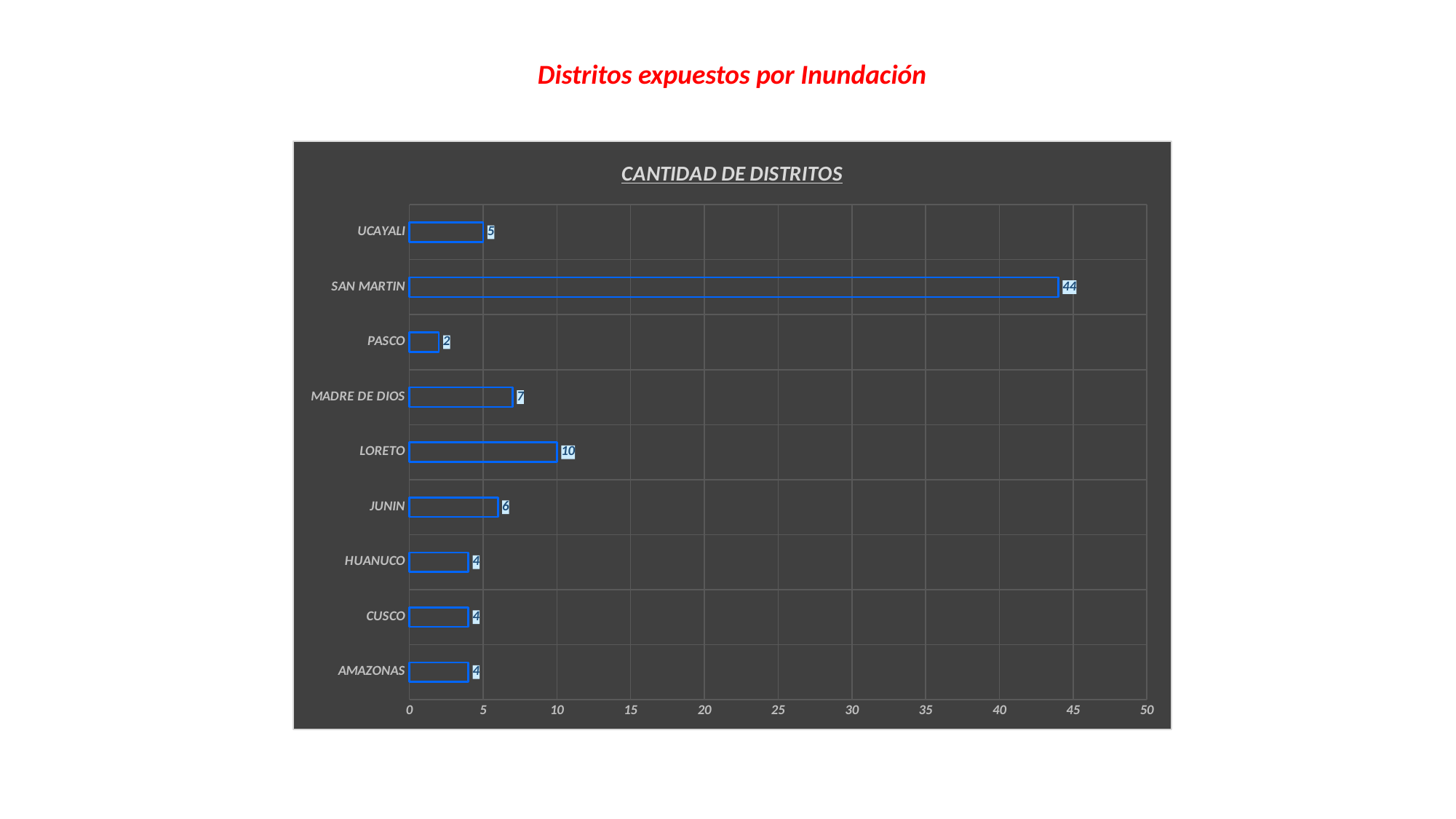
Which category has the lowest value? PASCO What is the difference between the values for SAN MARTIN and LORETO? 34 What is the value for MADRE DE DIOS? 7 What is the title of the chart? CANTIDAD DE DISTRITOS What is the value for LORETO? 10 What is the value for PASCO? 2 Which is larger, the value for JUNIN or the value for UCAYALI? JUNIN How many categories are shown in the chart? 9 What is the value for SAN MARTIN? 44 Which category has the highest value? SAN MARTIN What kind of chart is shown? bar chart Is the value for SAN MARTIN greater or less than 40? greater